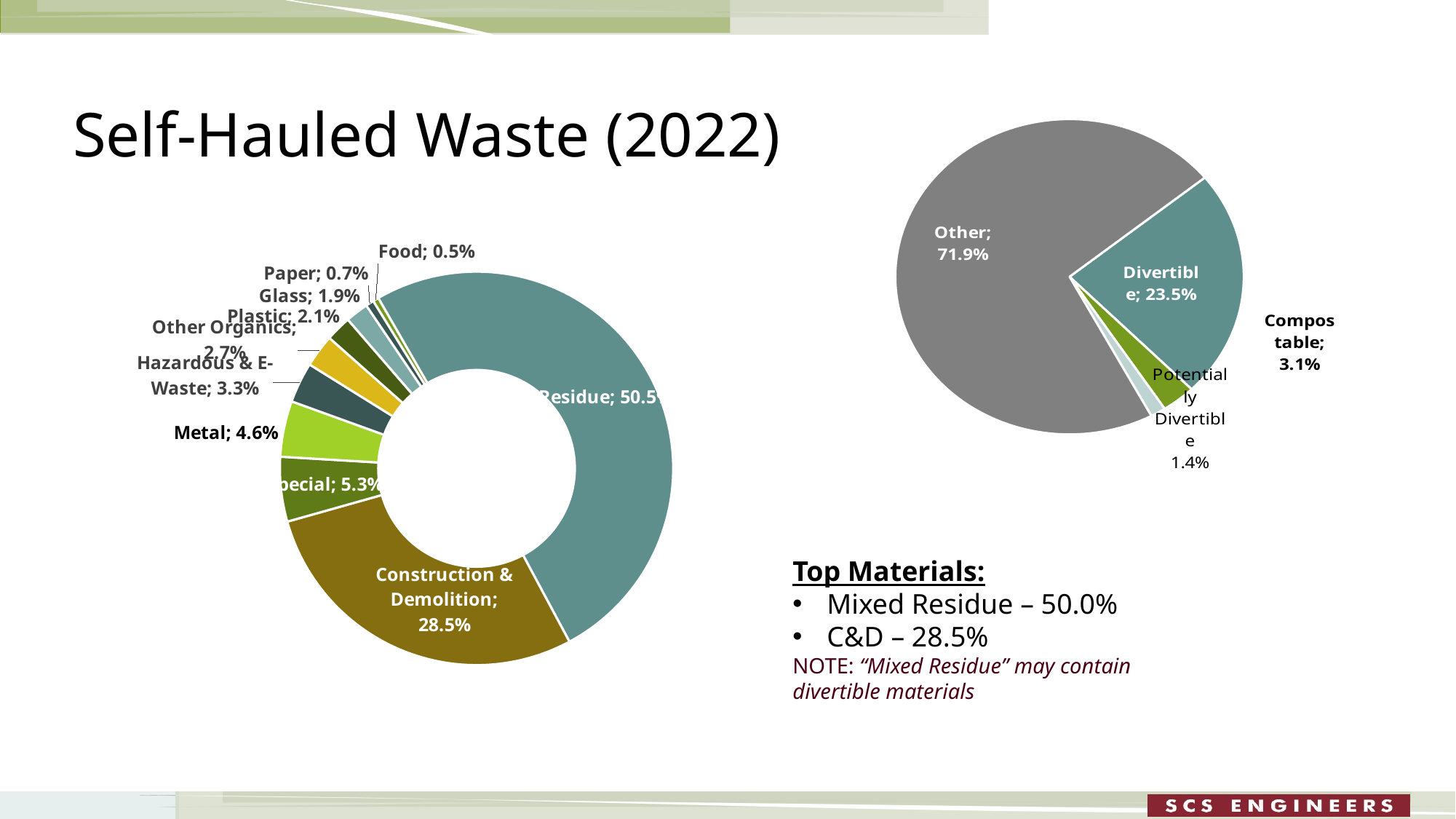
In the left doughnut chart, which is larger, Glass or Plastic? Plastic How many slices does the right pie chart have? 4 How many categories are shown in the left doughnut chart? 10 In the left doughnut chart, what percentage is shown for Metal? 4.6% In the right pie chart, which category has the largest share? Other In the left doughnut chart, what percentage is shown for Construction & Demolition? 28.5% In the right pie chart, what is the difference between the Compostable and Potentially Divertible percentages? 1.7% What type of chart is on the left of the slide? Doughnut chart In the right pie chart, what percentage is shown for Divertible? 23.5% In the left doughnut chart, which category has the smallest share? Food In the left doughnut chart, what is the difference between the Metal and Paper percentages? 3.9% In the left doughnut chart, what percentage is shown for Hazardous & E-Waste? 3.3%